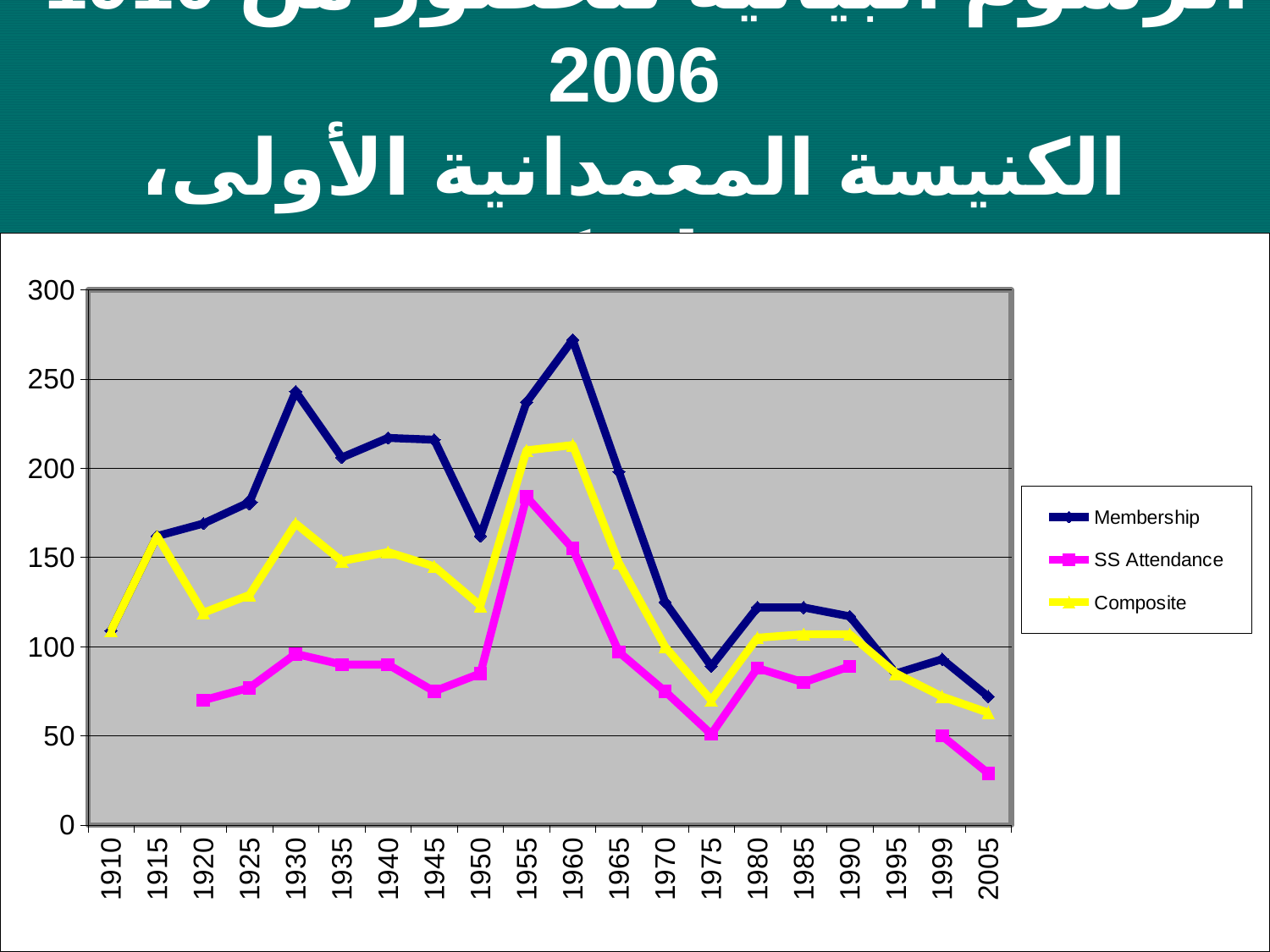
In which year does the Membership series reach its highest value? 1960 Which series has the larger value in 1960, Membership or SS Attendance? Membership What kind of chart is shown on the slide? line chart Is the Membership value for 1960 greater or less than 250? greater Is the Membership value for 1975 greater or less than 100? less What colour is the SS Attendance line? magenta How many series does the legend list? 3 How many years are labelled along the x axis? 20 In which year does the SS Attendance series reach its lowest value? 2005 Is the Composite value for 1955 greater or less than 200? greater Does the Membership series rise or fall between 1960 and 1975? fall